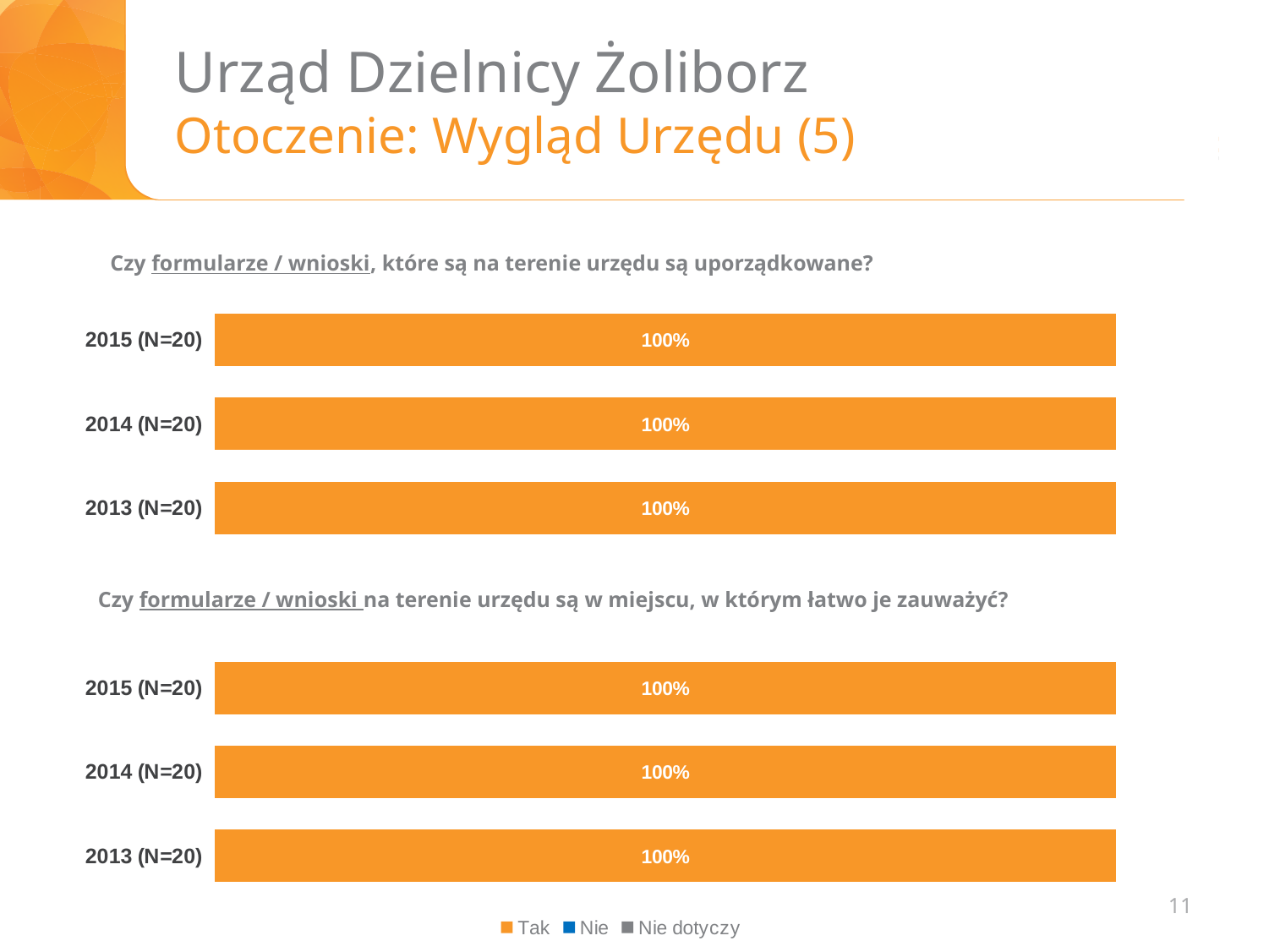
How many categories (years) are shown in the top chart? 3 In the top chart ("Czy formularze / wnioski, które są na terenie urzędu są uporządkowane?"), what is the value for 2013 (N=20)? 100% In the bottom chart ("Czy formularze / wnioski na terenie urzędu są w miejscu, w którym łatwo je zauważyć?"), what is the value for 2014 (N=20)? 100% In the top chart, do the values change from 2013 (N=20) to 2015 (N=20)? No, they stay at 100% In the bottom chart ("Czy formularze / wnioski na terenie urzędu są w miejscu, w którym łatwo je zauważyć?"), what is the value for 2015 (N=20)? 100% In the top chart ("Czy formularze / wnioski, które są na terenie urzędu są uporządkowane?"), what is the value for 2015 (N=20)? 100% In the top chart, what is the difference between the values for 2015 (N=20) and 2013 (N=20)? 0% In the bottom chart, what is the difference between the values for 2014 (N=20) and 2013 (N=20)? 0% What kind of chart is the top chart? Bar chart How many categories (years) are shown in the bottom chart? 3 Which legend entry corresponds to the orange bars on the slide? Tak How many series does the legend at the bottom of the slide list? 3